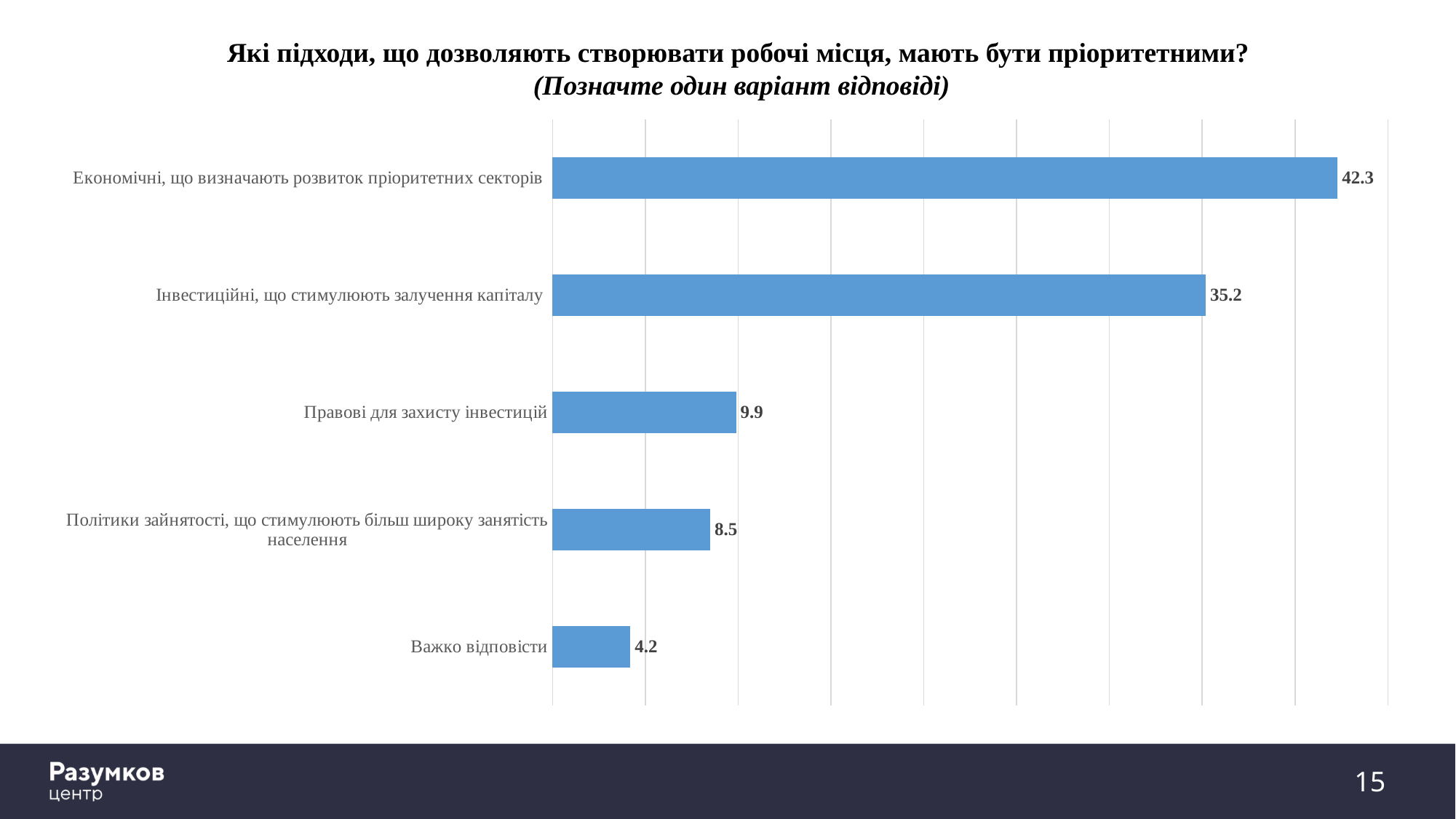
Which is larger: the value for "Правові для захисту інвестицій" or for "Політики зайнятості, що стимулюють більш широку занятість населення"? Правові для захисту інвестицій What kind of chart is shown on the slide? Bar chart What is the value for "Політики зайнятості, що стимулюють більш широку занятість населення"? 8.5 What is the difference between the values for "Правові для захисту інвестицій" and "Важко відповісти"? 5.7 How many categories are shown in the chart? 5 What is the value for "Інвестиційні, що стимулюють залучення капіталу"? 35.2 What is the value for "Важко відповісти"? 4.2 Which category has the lowest value? Важко відповісти What is the difference between the values for "Економічні, що визначають розвиток пріоритетних секторів" and "Інвестиційні, що стимулюють залучення капіталу"? 7.1 What is the value for "Економічні, що визначають розвиток пріоритетних секторів"? 42.3 What is the value for "Правові для захисту інвестицій"? 9.9 Which category has the highest value? Економічні, що визначають розвиток пріоритетних секторів